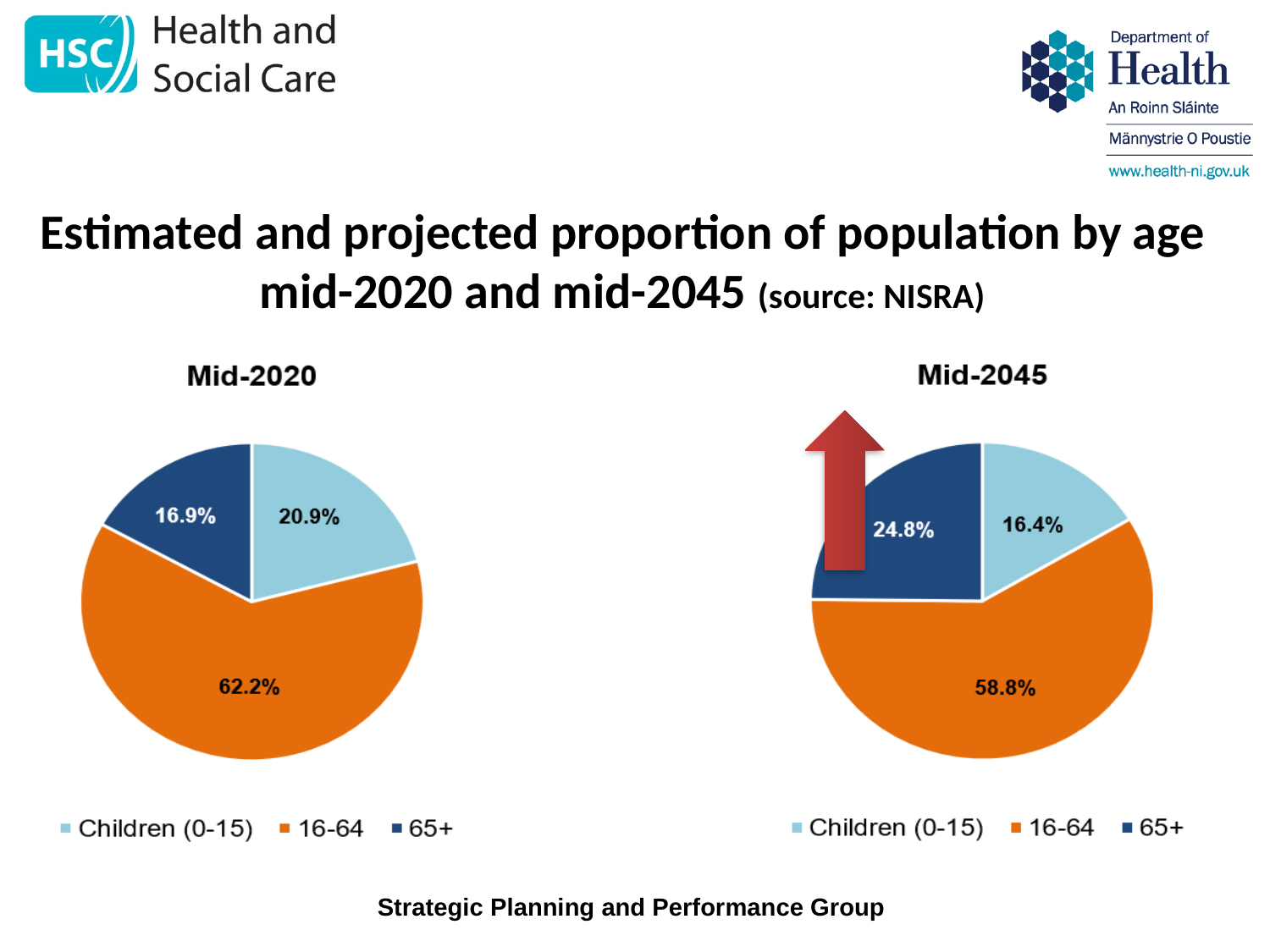
In the Mid-2045 pie chart, what is the difference between the 16-64 share and the 65+ share? 34 percentage points In the Mid-2045 pie chart, what share of the population is aged 16-64? 58.8% Which is larger: the Children (0-15) share in the Mid-2020 chart or the Children (0-15) share in the Mid-2045 chart? Mid-2020 How many slices does the Mid-2045 pie chart have? 3 In the Mid-2045 pie chart, what share of the population is aged 65+? 24.8% What type of chart is used for the Mid-2020 data? Pie chart In the Mid-2020 pie chart, which age group has the smallest share? 65+ In the Mid-2020 pie chart, what share of the population is aged 65+? 16.9% By how many percentage points does the 65+ share in the Mid-2045 chart exceed the 65+ share in the Mid-2020 chart? 7.9 percentage points In the Mid-2020 pie chart, what share of the population is Children (0-15)? 20.9% In the Mid-2045 pie chart, which age group has the smallest share? Children (0-15) In the Mid-2020 pie chart, which age group has the largest share? 16-64